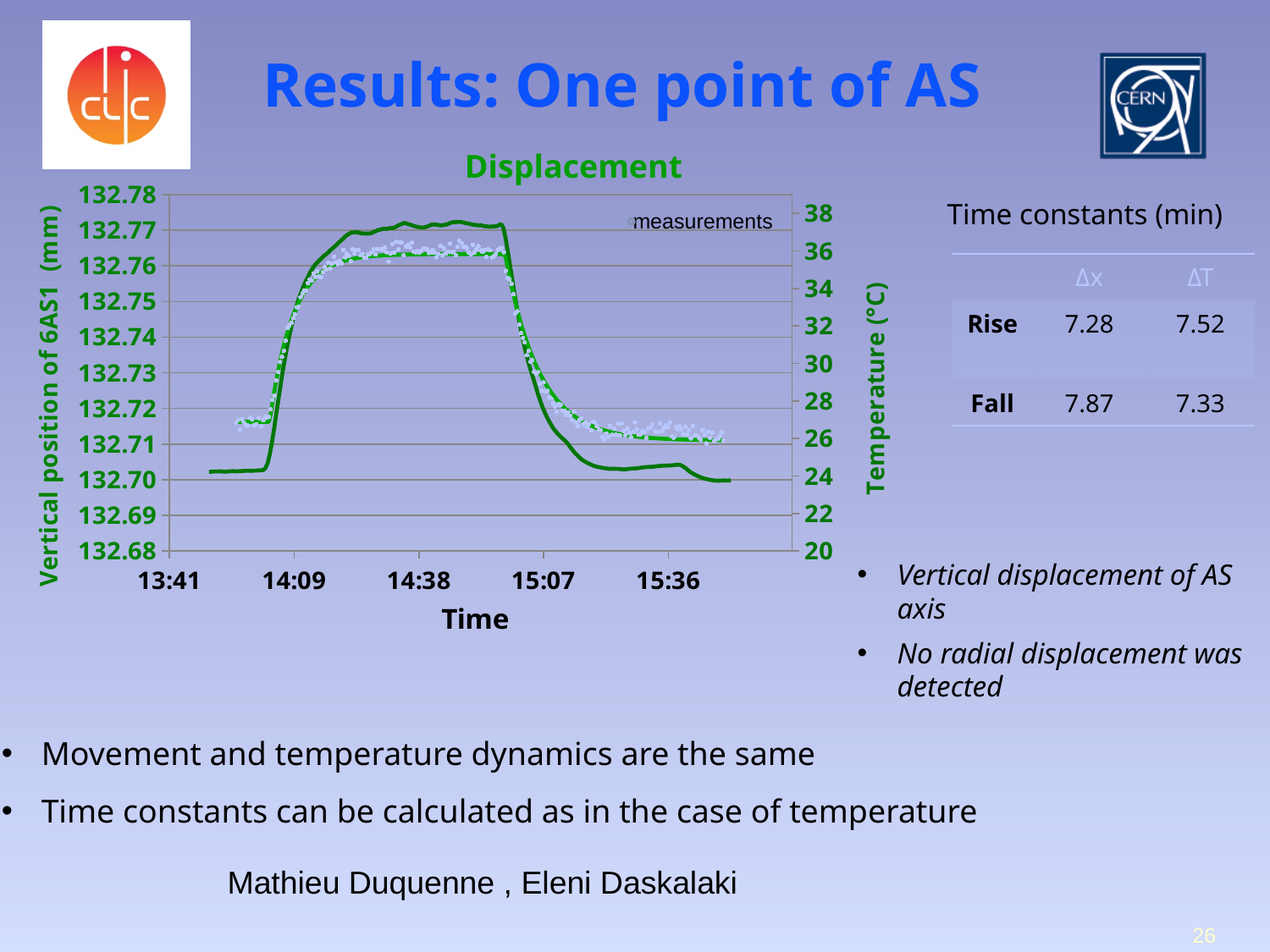
What entry does the chart's legend list? measurements What is the highest value shown on the right-hand temperature axis? 38 Between 14:09 and 14:38, do the measurements rise or fall? rise Is the temperature shown by the solid green line at 15:36 greater or less than 28 °C? less Is the value of the measurements at 15:36 greater or less than 132.73 mm? less Is the temperature shown by the solid green line at 14:38 greater or less than 36 °C? greater How many time labels are shown on the x axis of the chart? 5 How many series does the chart's legend list? 1 What kind of chart is shown on the slide? line chart Between 15:07 and 15:36, do the measurements rise or fall? fall What is the title of the chart? Displacement